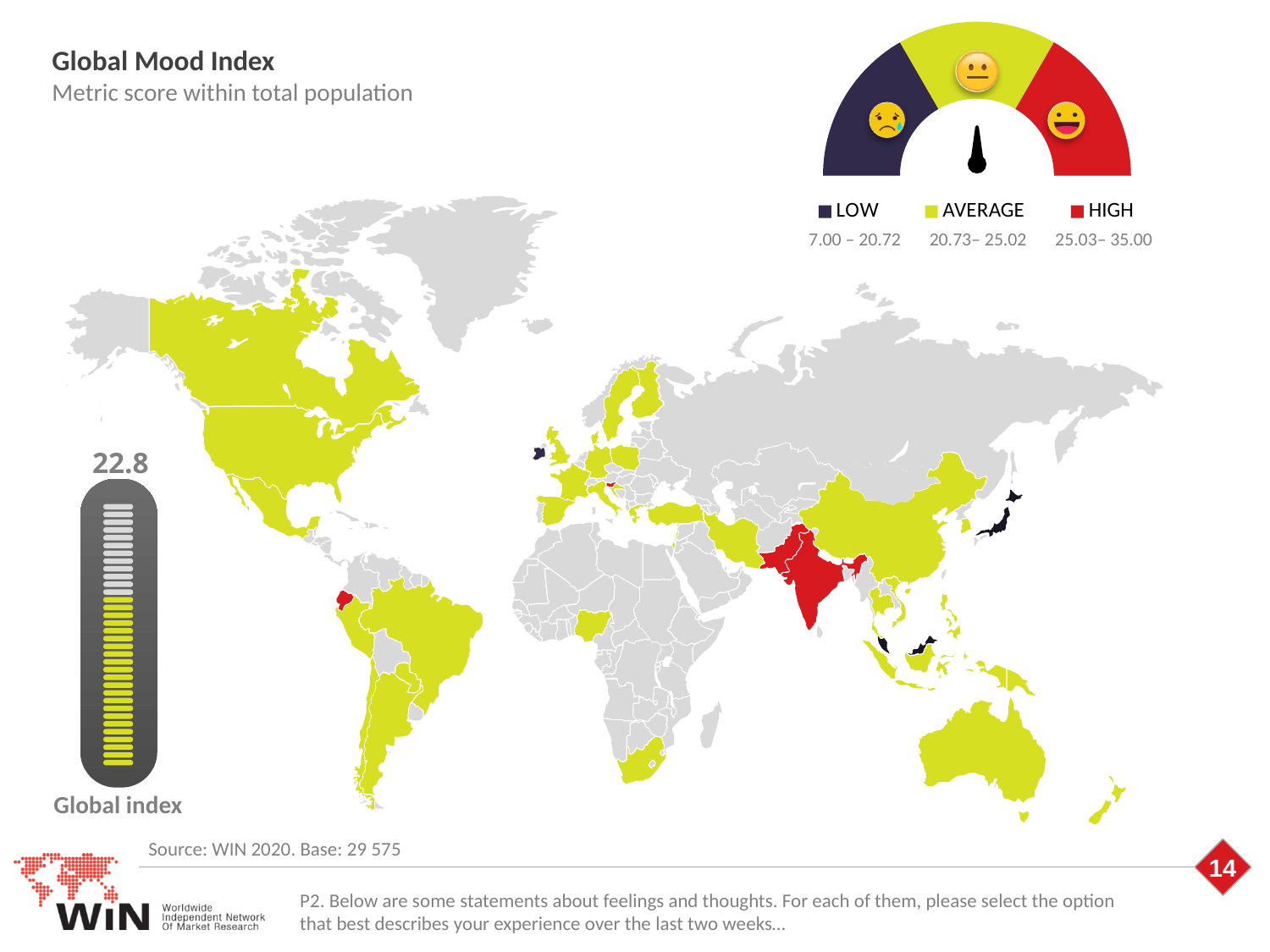
What score range does the legend give for the LOW category? 7.00 – 20.72 Which mood category is Japan shaded as on the map? LOW Which mood category is India shaded as on the map? HIGH What is the title of the chart on the slide? Global Mood Index What score range does the legend give for the HIGH category? 25.03 – 35.00 Is the Global index value of 22.8 greater or less than 20? greater How many categories does the legend list for the Global Mood Index? 3 What score range does the legend give for the AVERAGE category? 20.73 – 25.02 Which legend category does the Global index value of 22.8 fall into? AVERAGE Which colour represents the HIGH category in the legend? Red What kind of chart is used to show the Global Mood Index by country? Map chart What is the value shown for the Global index on the slide? 22.8